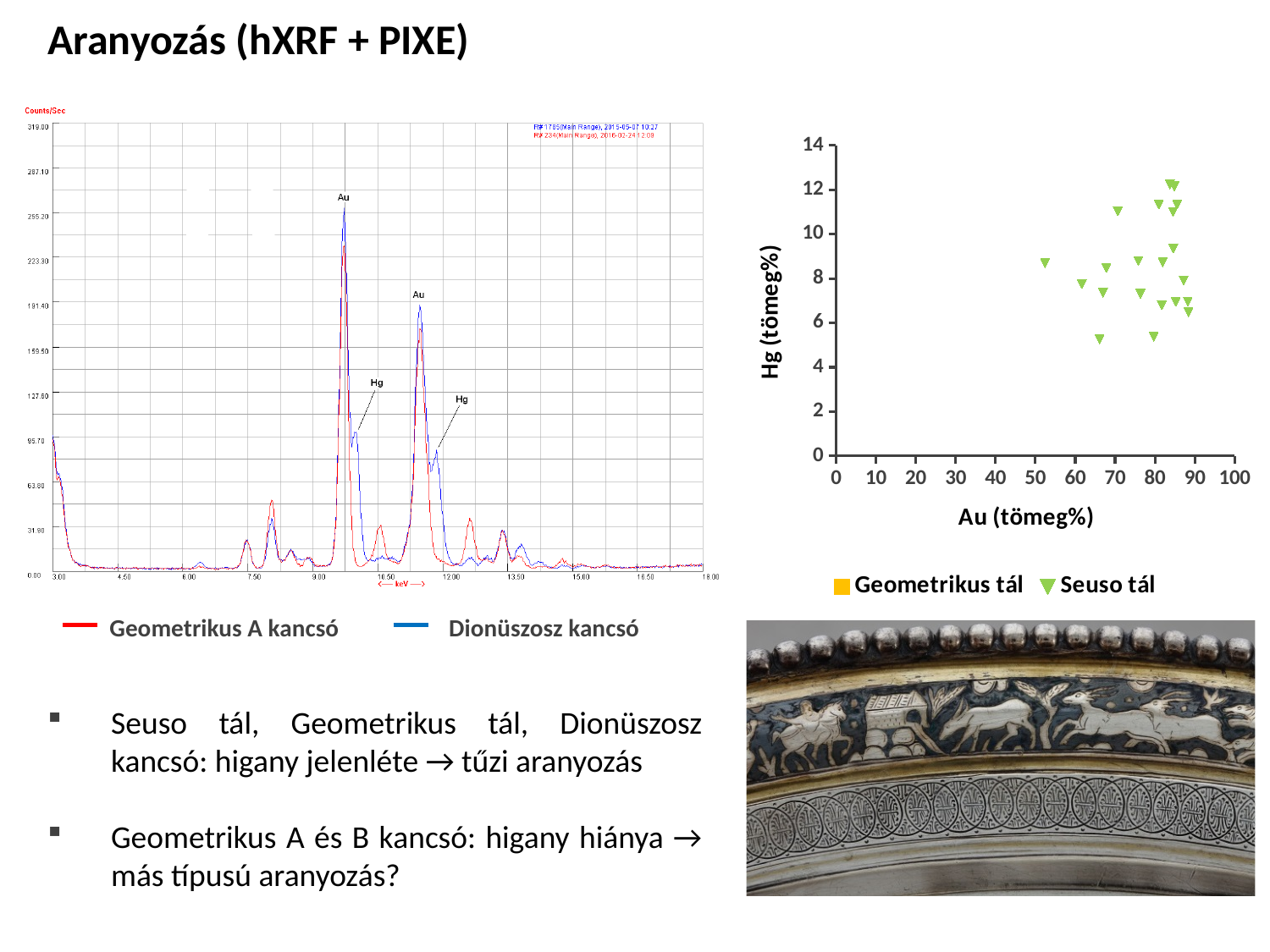
In the spectrum chart on the left, how many series does the legend list? 2 In the scatter chart on the right, is the highest Au value for Seuso tál greater or less than 100? less In the scatter chart on the right, is the highest Hg value for Seuso tál greater or less than 10? greater In the spectrum chart on the left, which series shows the peaks labelled Hg? Dionüszosz kancsó What kind of chart is the chart on the right of the slide (Hg vs Au)? scatter chart In the spectrum chart on the left, which series has the higher Au peak near 9.7 keV, Geometrikus A kancsó or Dionüszosz kancsó? Dionüszosz kancsó In the scatter chart on the right, is the lowest Au value for Seuso tál greater or less than 40? greater What kind of chart is the chart on the left of the slide (the spectrum)? line chart In the scatter chart on the right, how many series does the legend list? 2 In the scatter chart on the right, what is the label of the x axis? Au (tömeg%) In the spectrum chart on the left, what colour is the line for Geometrikus A kancsó? red